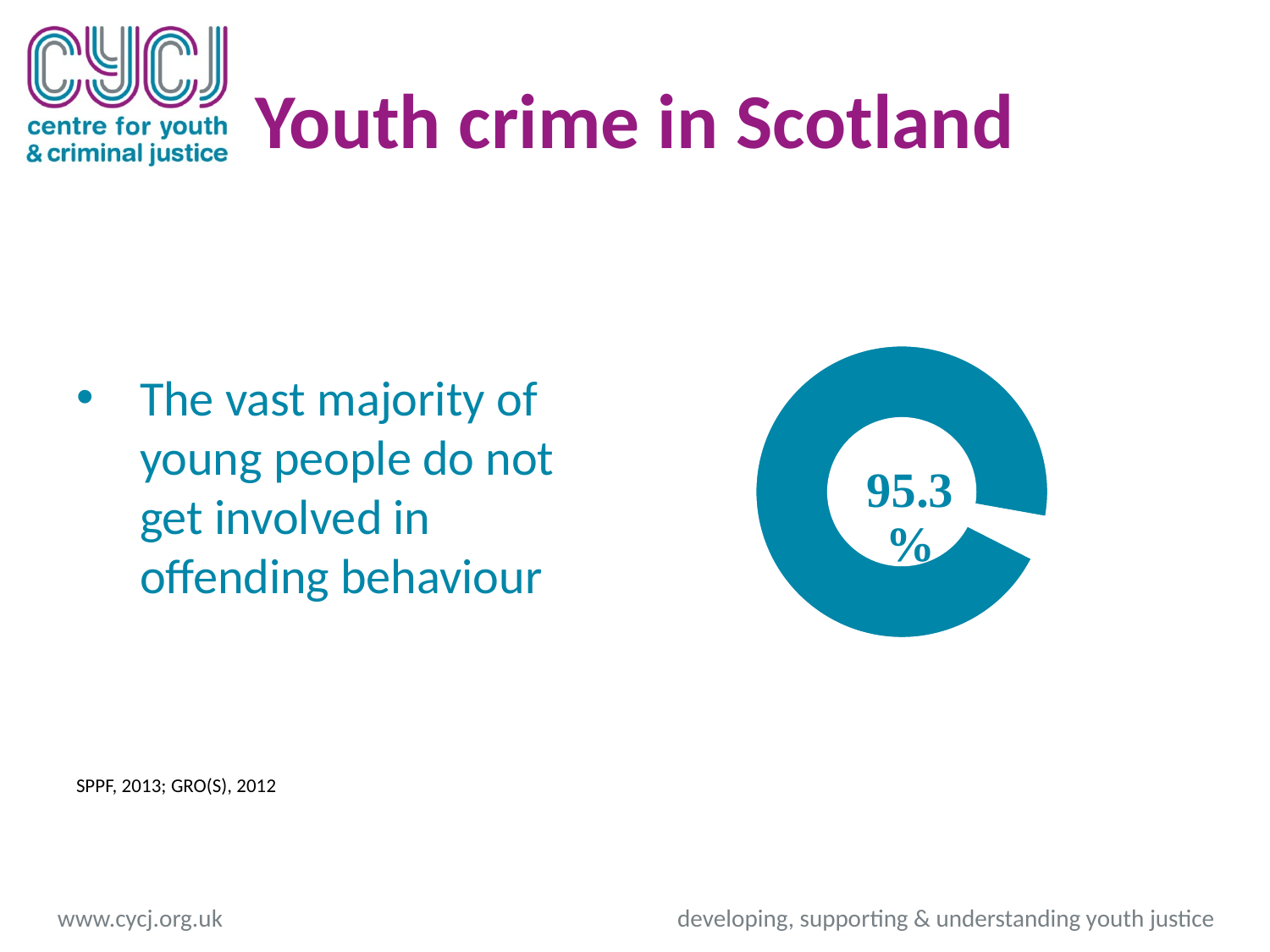
What kind of chart is shown on the slide? Doughnut chart What share of the doughnut chart does the large blue segment represent? 95.3% Does the doughnut chart display a legend? No What value is printed in the centre of the doughnut chart? 95.3% Is the value shown in the doughnut chart greater or less than 90%? greater Which is larger in the doughnut chart, the blue segment or the white gap? The blue segment What colour is the main segment of the doughnut chart? Blue